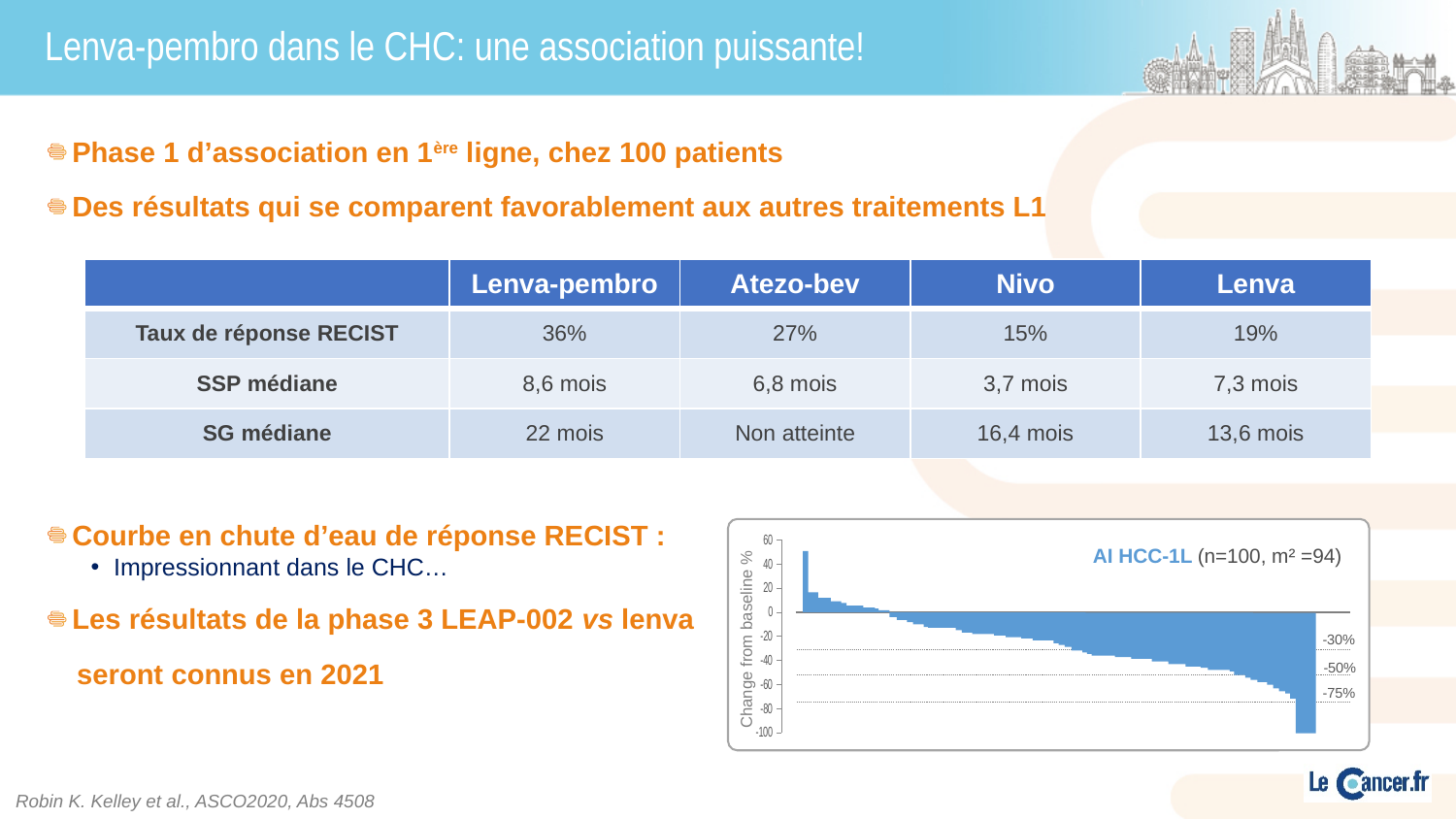
What is the label of the y axis of the waterfall chart? Change from baseline % In the waterfall chart, is the value of the lowest bar (rightmost) greater or less than -80? less In the waterfall chart, do the bar values rise or fall from left to right along the x axis? fall In the waterfall chart, is the value of the lowest bar (rightmost) greater or less than -60? less In the waterfall chart, is the value of the tallest positive bar (leftmost) greater or less than 40? greater What kind of chart is shown at the bottom right of the slide? bar chart In the waterfall chart, are most of the bars above or below zero? below What is the value of n given in the label inside the waterfall chart (AI HCC-1L)? n=100